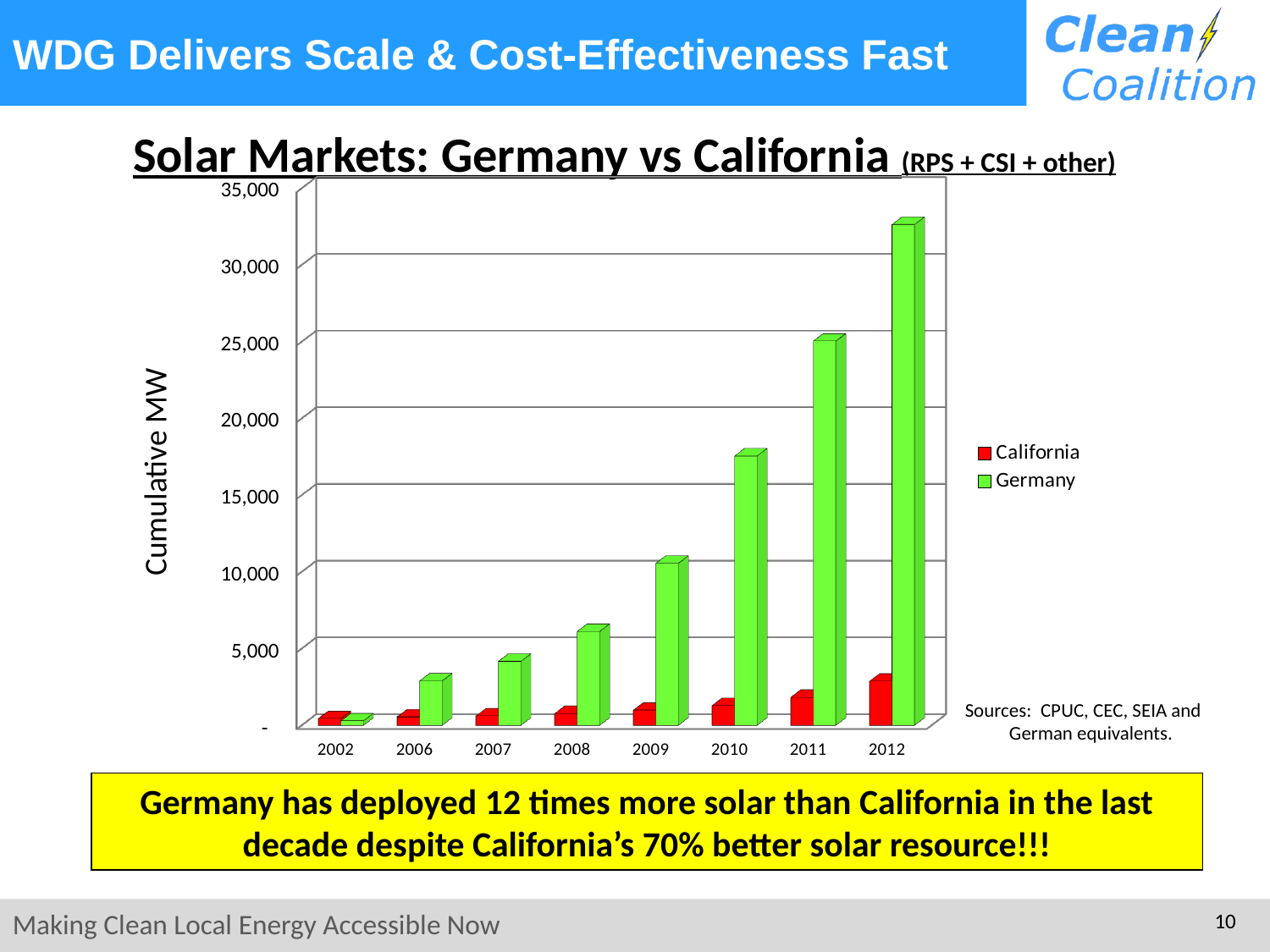
Is the value for Germany in 2012 greater or less than 30,000? greater How many years are shown along the x axis of the chart? 8 In which year is the Germany bar the highest? 2012 Is the value for California in 2012 greater or less than 5,000? less In 2012, which is larger, the value for Germany or the value for California? Germany How many series does the chart's legend list? 2 Which colour represents Germany in the chart's legend? green Is the value for Germany in 2010 greater or less than 15,000? greater Do the Germany values rise or fall from 2002 to 2012? rise In which year is the Germany bar the lowest? 2002 What is the label on the y axis of the chart? Cumulative MW What kind of chart is shown on the slide? bar chart